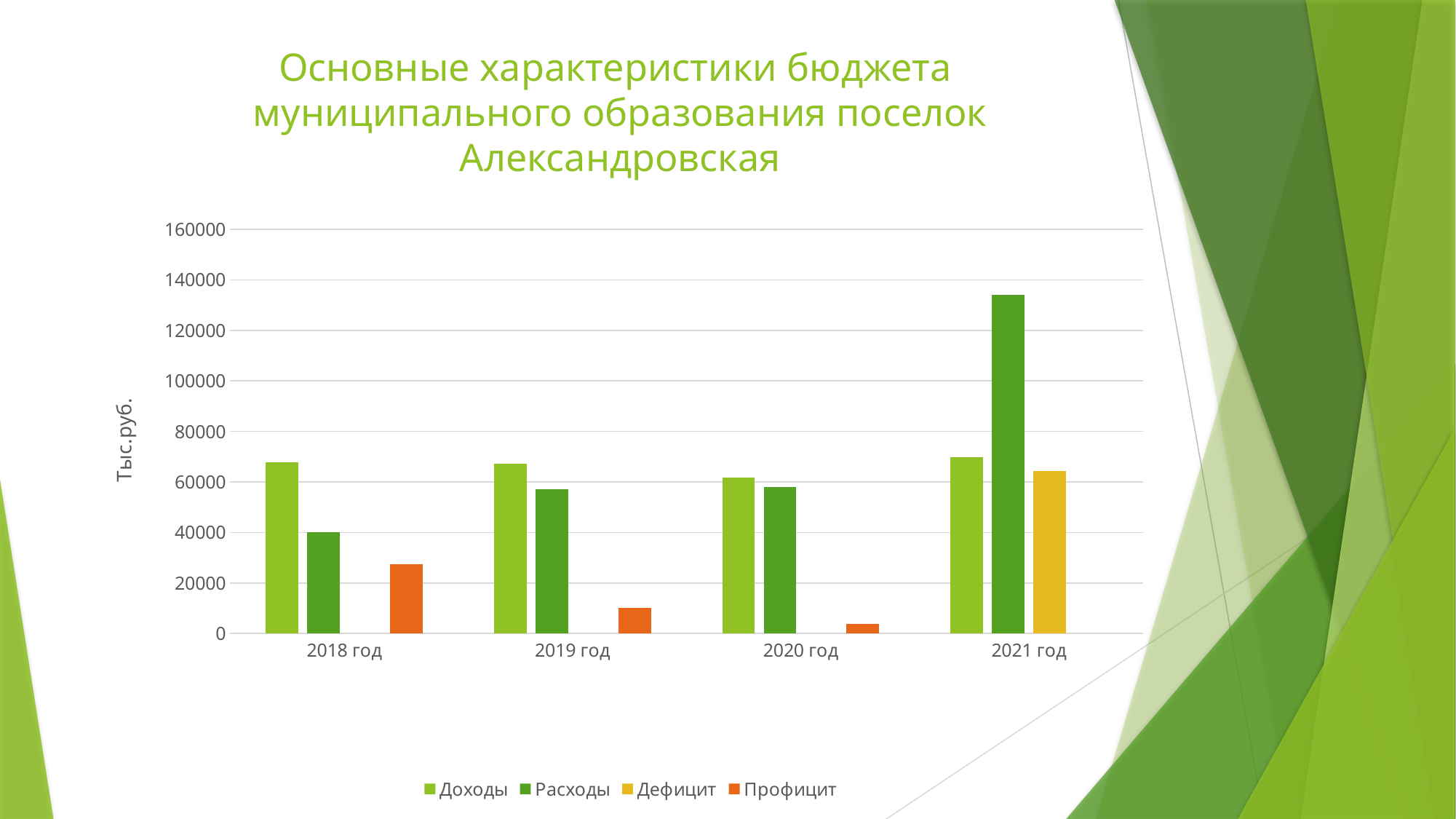
In which year is Профицит the lowest among the years where it is shown? 2020 год How many series does the legend list? 4 How many years are shown on the x axis? 4 In which year are Расходы the highest? 2021 год In 2018 год, which is larger: Доходы or Расходы? Доходы Is the value for Дефицит in 2021 год greater or less than 40000? greater What kind of chart is shown on the slide? Bar chart Is the value for Расходы in 2018 год greater or less than 60000? less Is the value for Расходы in 2021 год greater or less than 120000? greater Does Профицит rise or fall from 2018 год to 2020 год? fall What is the label on the vertical axis? Тыс.руб. In 2021 год, which is larger: Доходы or Расходы? Расходы